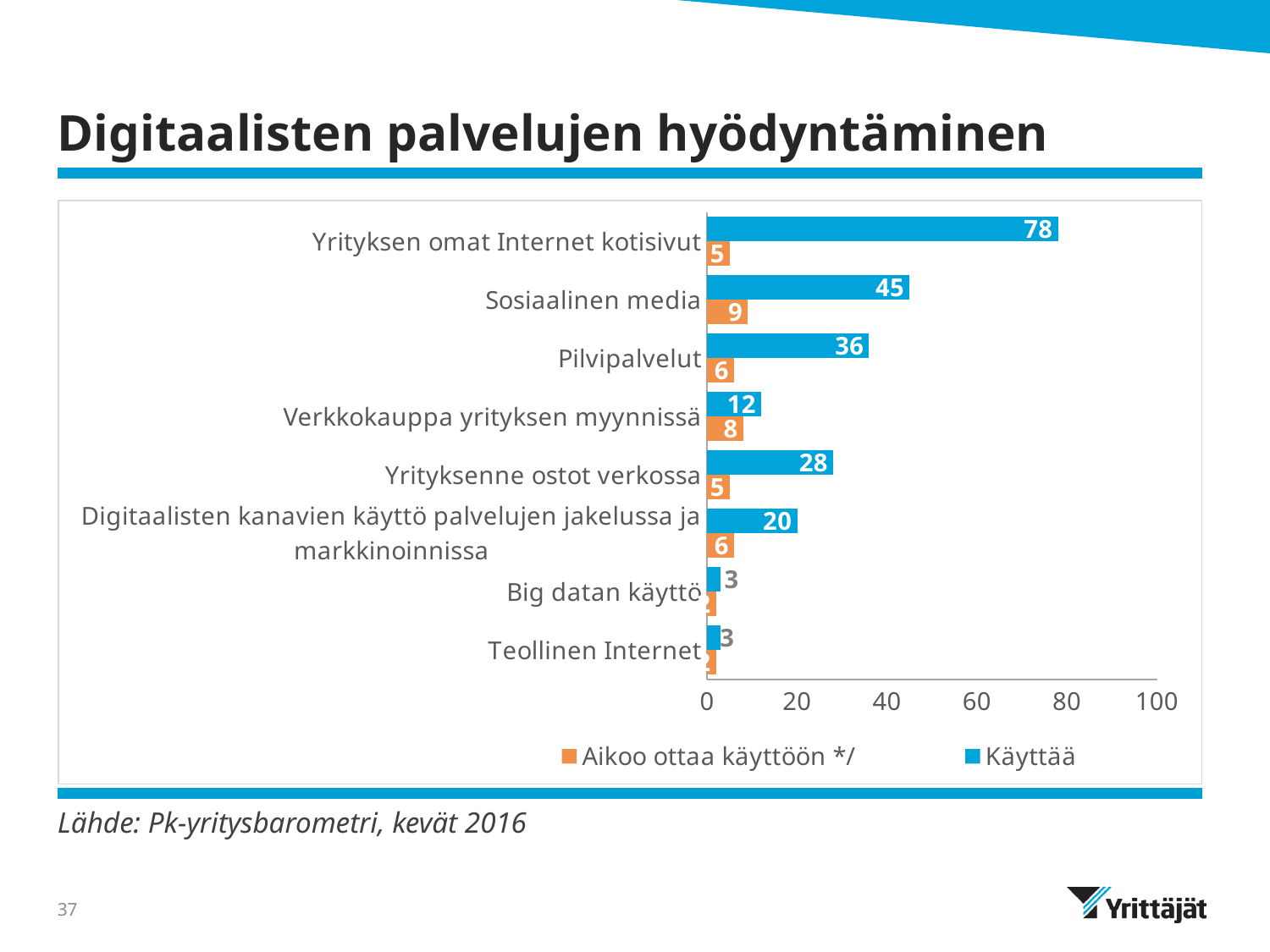
What is the Käyttää value for Yrityksen omat Internet kotisivut? 78 How many categories are shown in the chart? 8 What is the Aikoo ottaa käyttöön value for Sosiaalinen media? 9 What is the Käyttää value for Pilvipalvelut? 36 Which category has the highest Käyttää value? Yrityksen omat Internet kotisivut Is the Käyttää value for Yrityksen omat Internet kotisivut greater or less than 60? greater Which is larger, the Käyttää value for Yrityksenne ostot verkossa or for Digitaalisten kanavien käyttö palvelujen jakelussa ja markkinoinnissa? Yrityksenne ostot verkossa What kind of chart is shown on the slide? Bar chart Which category has the highest Aikoo ottaa käyttöön value? Sosiaalinen media What is the Aikoo ottaa käyttöön value for Verkkokauppa yrityksen myynnissä? 8 How many series does the legend list? 2 What is the difference between the Käyttää values for Sosiaalinen media and Pilvipalvelut? 9